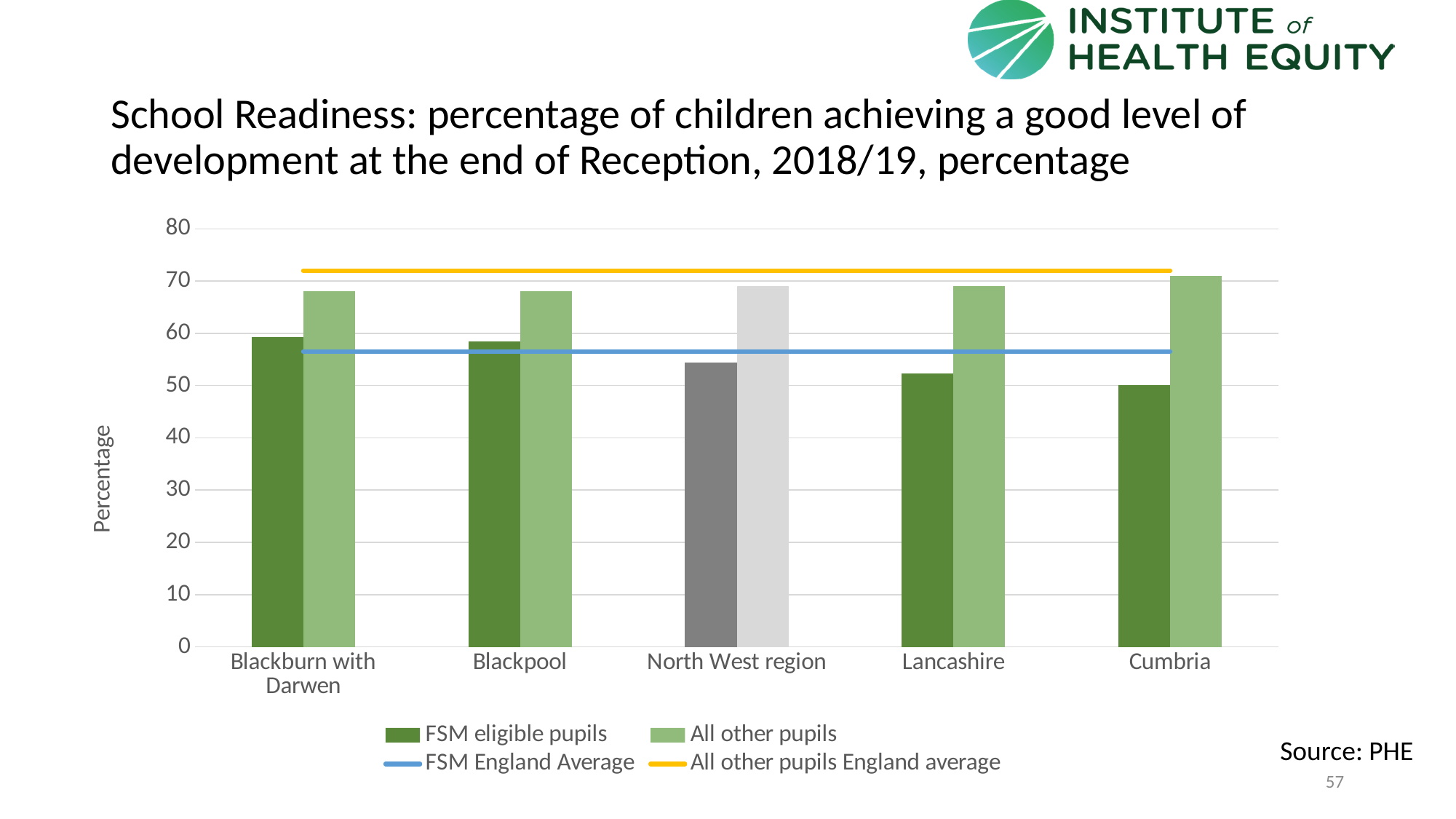
What kind of chart is shown on the slide? Bar chart Which area has the highest value for All other pupils? Cumbria How many areas (categories) are shown along the x axis? 5 Which is larger: the FSM eligible pupils value for Lancashire or for Cumbria? Lancashire What does the yellow horizontal line represent according to the legend? All other pupils England average Which area has the lowest value for FSM eligible pupils? Cumbria Is the value for FSM eligible pupils in Lancashire greater or less than 60? less Is the value for All other pupils in Blackpool greater or less than 70? less Is the value for All other pupils in Cumbria greater or less than 70? greater How many series does the legend list? 4 Do the FSM eligible pupils values rise or fall moving from Blackburn with Darwen to Cumbria along the x axis? Fall